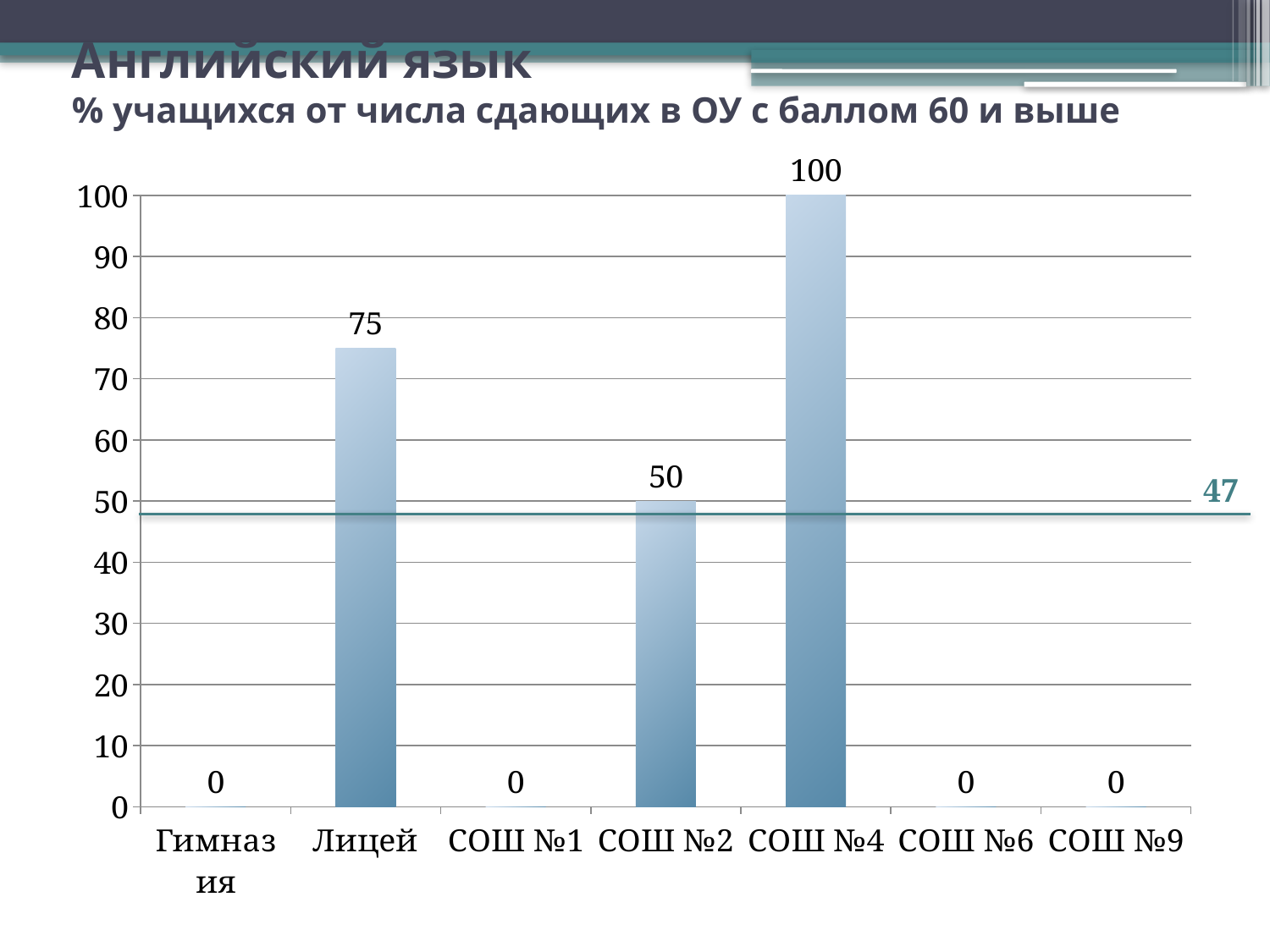
Which is larger, the value for Лицей or the value for СОШ №2? Лицей What is the value for Лицей? 75 Which category has the highest value? СОШ №4 What is the value for СОШ №2? 50 How many categories have a value of 0? 4 What is the value for СОШ №4? 100 What is the value for Гимназия? 0 What kind of chart is shown on the slide? bar chart How many categories are shown on the x axis? 7 What is the difference between the values for СОШ №4 and Лицей? 25 What is the difference between the values for Лицей and СОШ №2? 25 What value is labelled on the horizontal reference line across the chart? 47